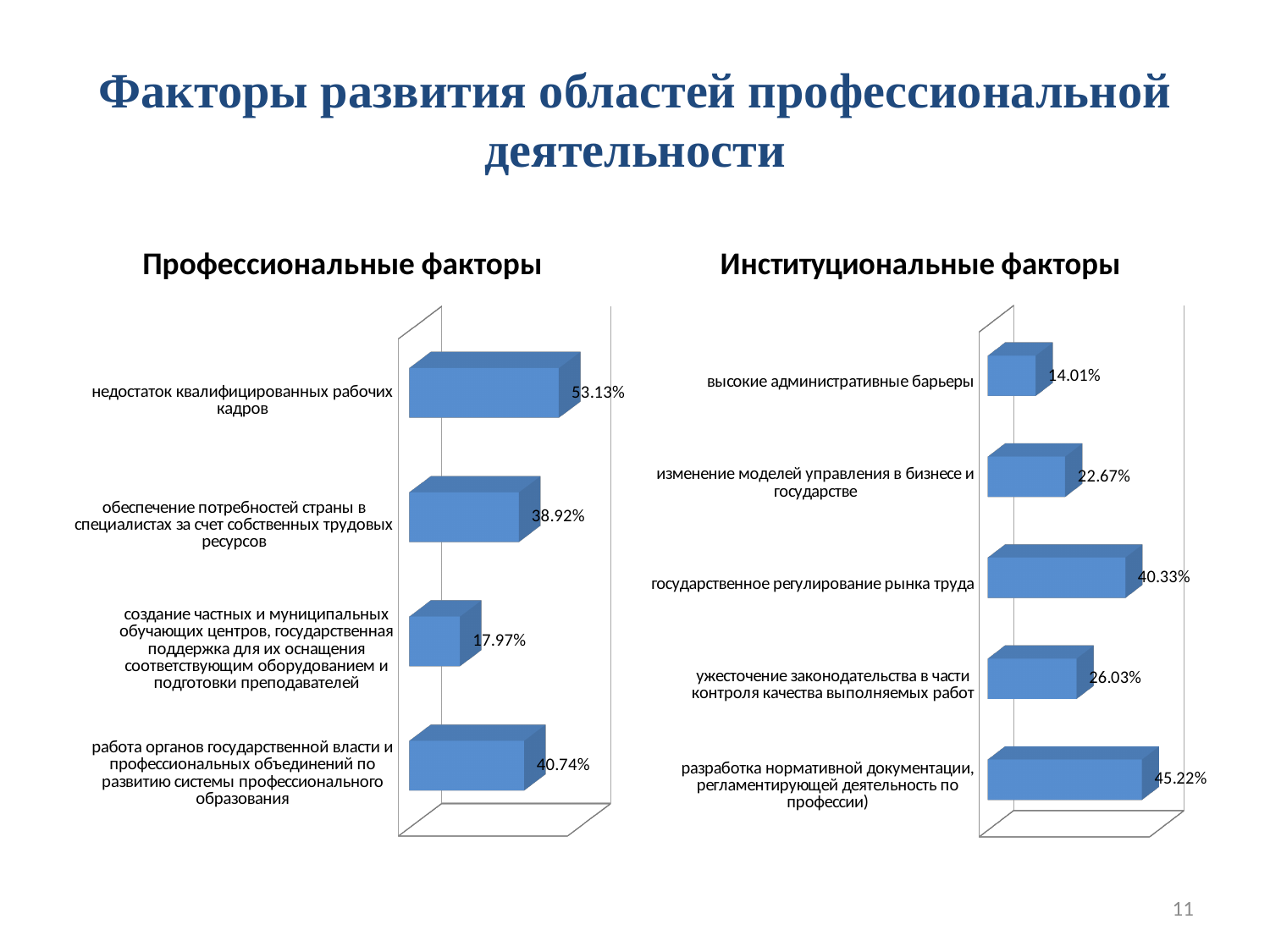
In the 'Профессиональные факторы' chart, which category has the lowest value? создание частных и муниципальных обучающих центров, государственная поддержка для их оснащения соответствующим оборудованием и подготовки преподавателей What kind of chart is the 'Институциональные факторы' chart? Bar chart How many categories are shown in the 'Профессиональные факторы' chart? 4 How many categories are shown in the 'Институциональные факторы' chart? 5 In the 'Институциональные факторы' chart, what is the difference between 'разработка нормативной документации, регламентирующей деятельность по профессии)' and 'высокие административные барьеры'? 31.21% What is the title of the chart on the left side of the slide? Профессиональные факторы In the 'Институциональные факторы' chart, which category has the highest value? разработка нормативной документации, регламентирующей деятельность по профессии) In the 'Профессиональные факторы' chart, what is the difference between 'работа органов государственной власти и профессиональных объединений по развитию системы профессионального образования' and 'обеспечение потребностей страны в специалистах за счет собственных трудовых ресурсов'? 1.82% In the 'Институциональные факторы' chart, what is the value for 'государственное регулирование рынка труда'? 40.33% In the 'Институциональные факторы' chart, which is larger: 'изменение моделей управления в бизнесе и государстве' or 'ужесточение законодательства в части контроля качества выполняемых работ'? ужесточение законодательства в части контроля качества выполняемых работ In the 'Профессиональные факторы' chart, what is the value for 'недостаток квалифицированных рабочих кадров'? 53.13% In the 'Институциональные факторы' chart, which category has the lowest value? высокие административные барьеры